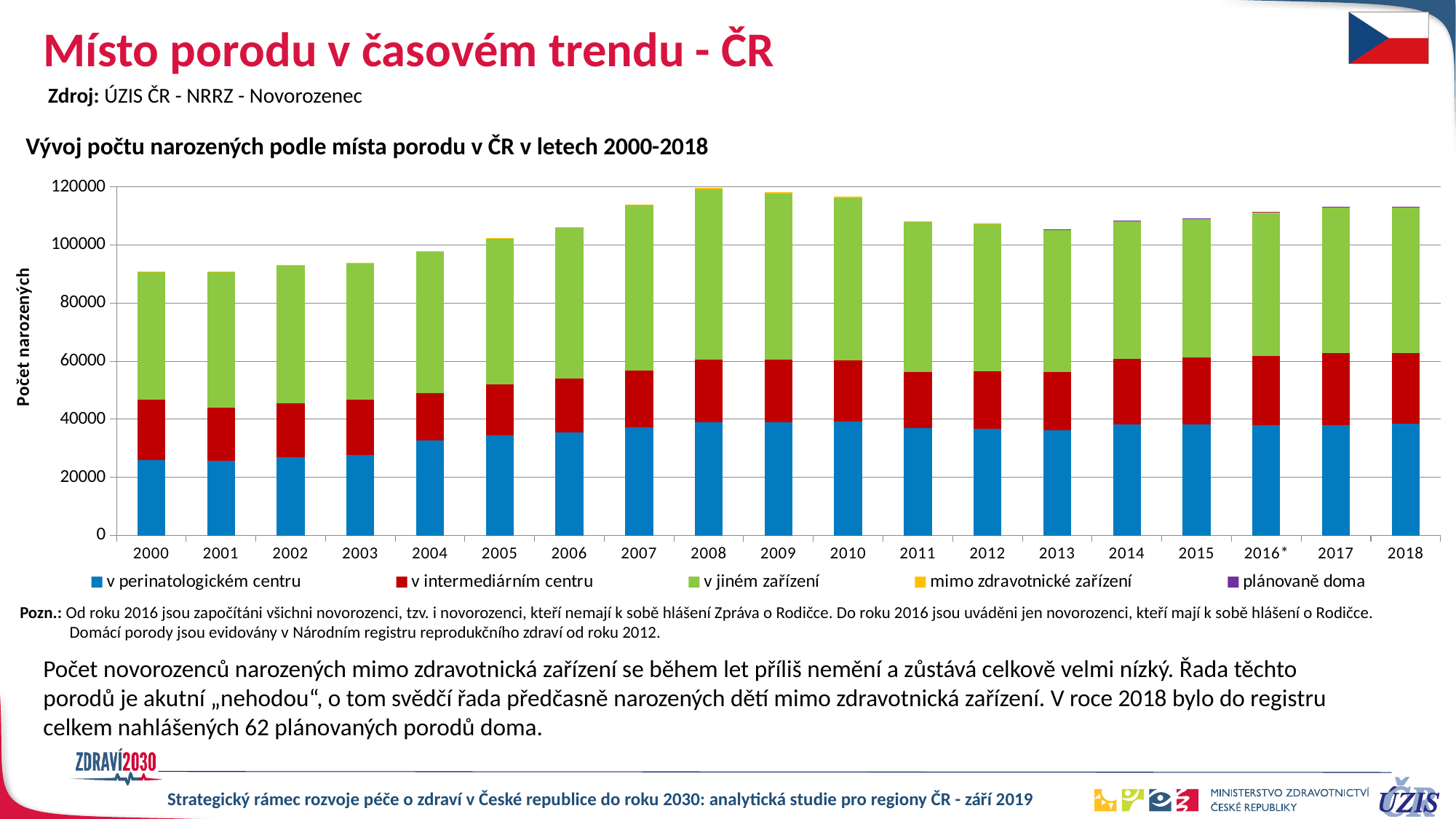
Is the total height of the bar for 2000 greater or less than 80000? greater What is the title of the chart? Vývoj počtu narozených podle místa porodu v ČR v letech 2000-2018 Which year has the larger total bar, 2000 or 2008? 2008 Is the total height of the bar for 2008 greater or less than 100000? greater Is the total height of the bar for 2004 greater or less than 100000? less How many series does the chart legend list? 5 What kind of chart is shown on the slide? Stacked bar chart What is the label of the vertical axis of the chart? Počet narozených How many years (categories) are shown on the x axis of the chart? 19 Do the total bar heights rise or fall from 2000 to 2008? rise